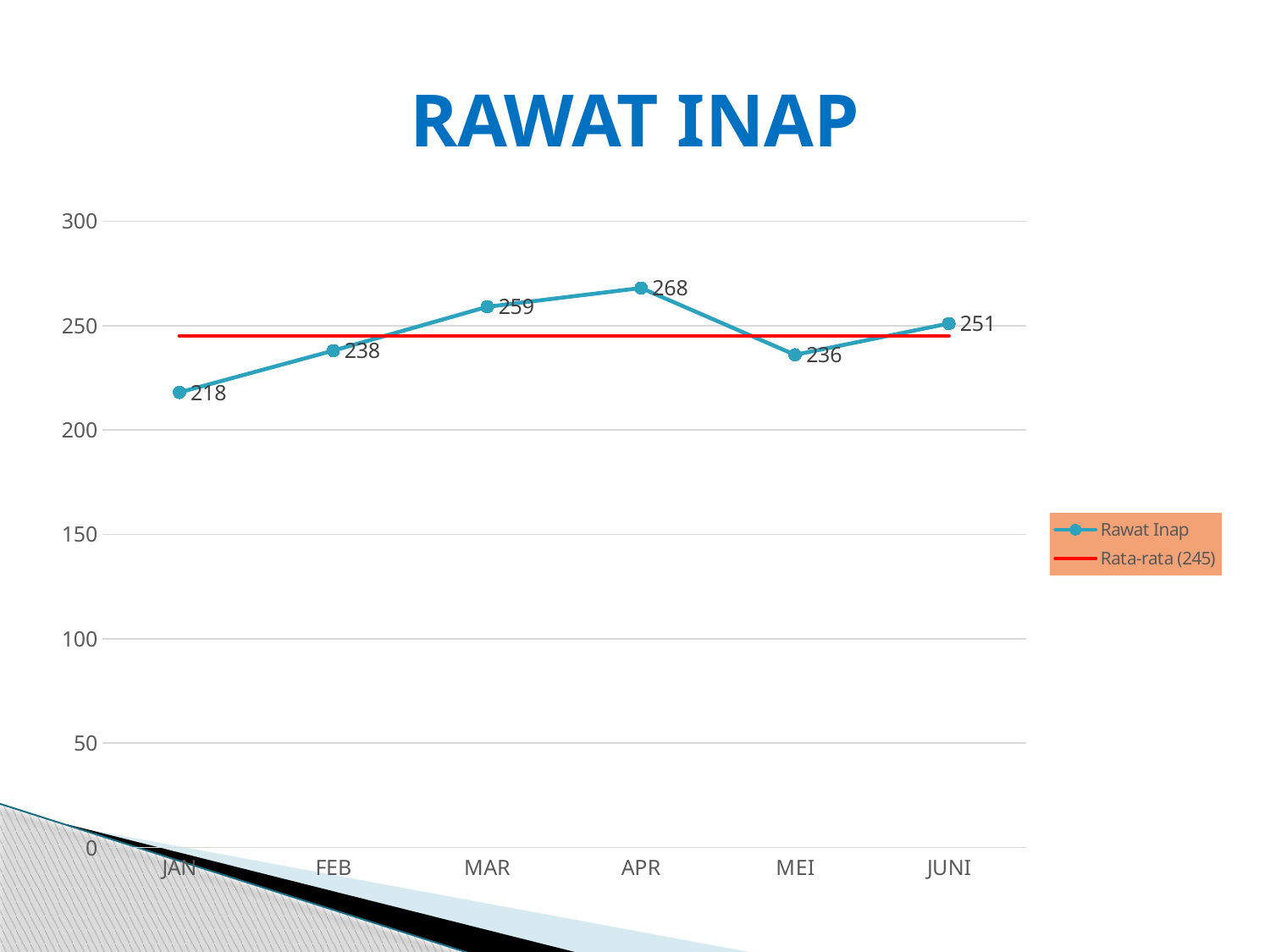
What value does the legend give for the Rata-rata line? 245 How many months are shown on the x axis? 6 How many series does the legend list? 2 What is the Rawat Inap value for MEI? 236 What is the difference between the Rawat Inap values for APR and JAN? 50 Which is larger, the Rawat Inap value for MAR or for JUNI? MAR What kind of chart is shown on the slide? line chart Which month has the highest Rawat Inap value? APR Which month has the lowest Rawat Inap value? JAN What is the Rawat Inap value for APR? 268 Is the Rawat Inap value for FEB greater or less than 250? less What is the Rawat Inap value for JAN? 218